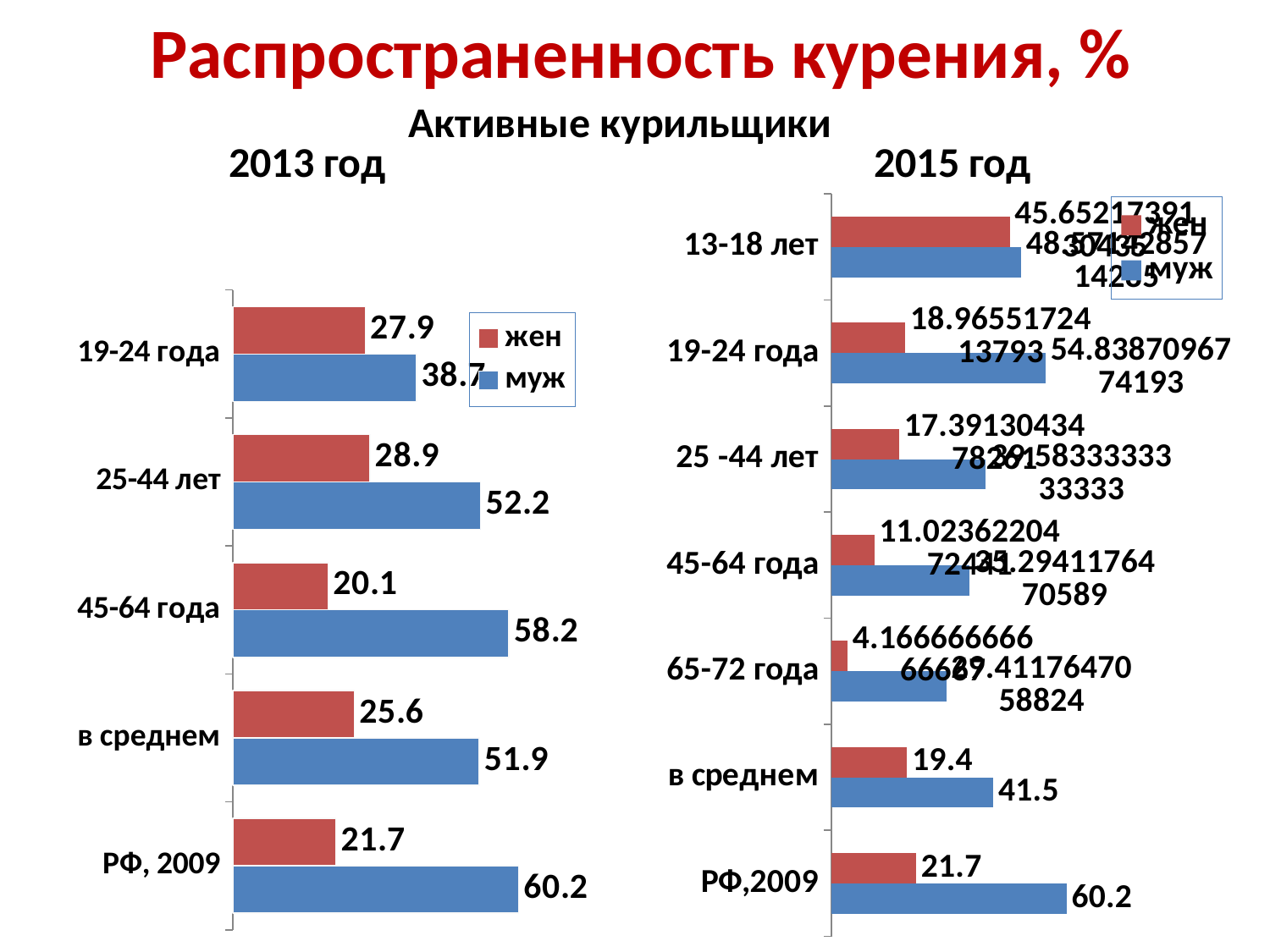
What type of chart is the 2015 год chart? bar chart In the 2013 год chart, what is the value for муж in the 45-64 года category? 58.2 In the 2013 год chart, which category has the highest муж value? РФ, 2009 In the 2013 год chart, what is the difference between the муж and жен values for 25-44 лет? 23.3 In the 2013 год chart, which category has the lowest жен value? 45-64 года How many categories are shown in the 2015 год chart? 7 How many series does the legend of the 2015 год chart list? 2 In the 2013 год chart, what is the value for жен in the 19-24 года category? 27.9 In the 2015 год chart, what is the value for муж in the в среднем category? 41.5 In the 2015 год chart, what is the value for жен in the РФ,2009 category? 21.7 In the 2013 год chart, which is larger for в среднем: the жен value or the муж value? муж How many categories are shown in the 2013 год chart? 5